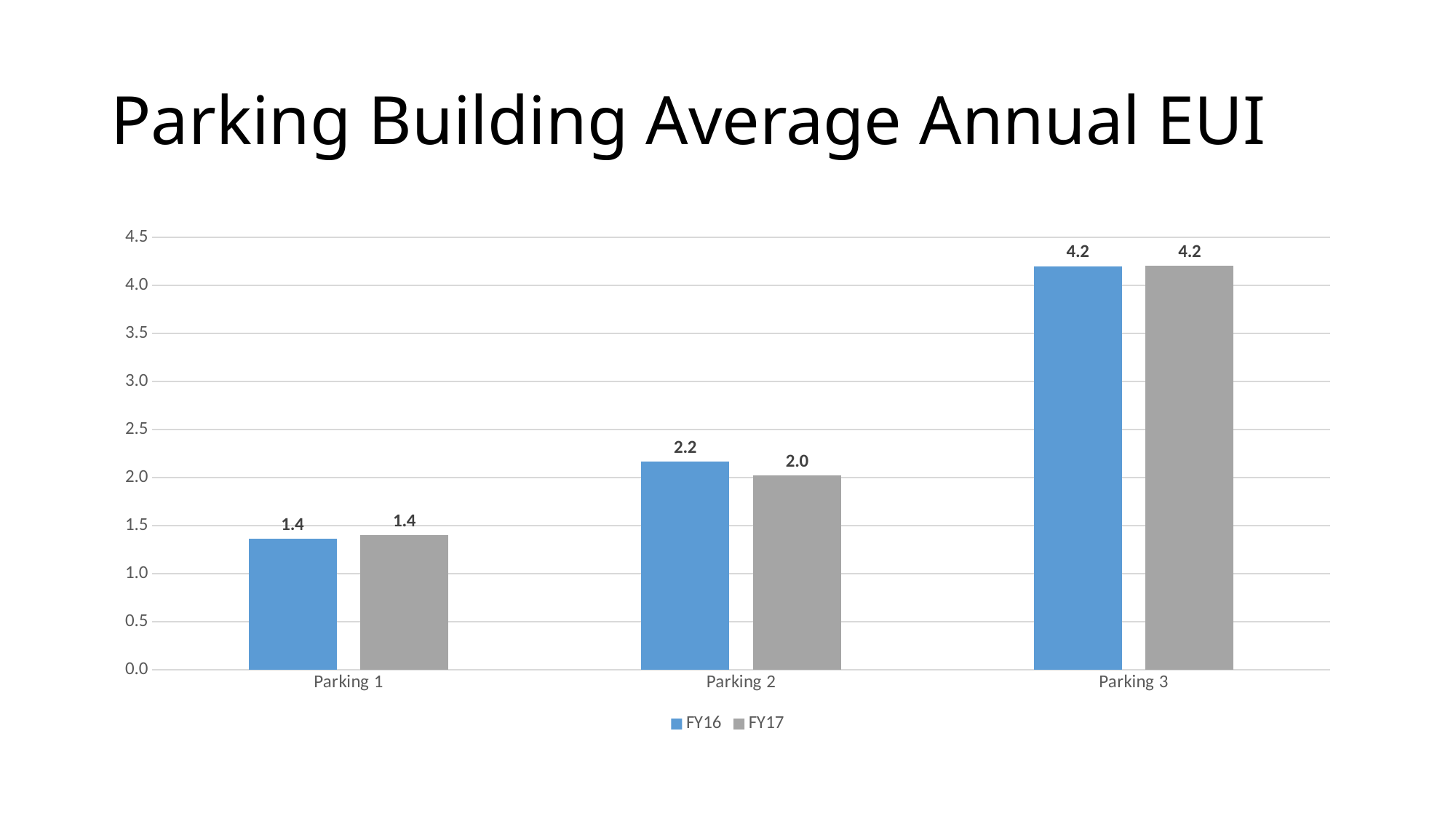
What is the FY16 value for Parking 2? 2.2 How many parking buildings are shown on the x axis? 3 Which parking building has the highest FY16 value? Parking 3 What is the difference between the FY16 values for Parking 3 and Parking 1? 2.8 What is the difference between the FY16 and FY17 values for Parking 2? 0.2 Is the FY17 value for Parking 3 greater or less than 4.0? greater For Parking 2, which is larger, the FY16 value or the FY17 value? FY16 What kind of chart is shown on the slide? Bar chart How many series does the legend list? 2 What is the FY17 value for Parking 1? 1.4 Which parking building has the lowest FY17 value? Parking 1 What is the FY17 value for Parking 3? 4.2